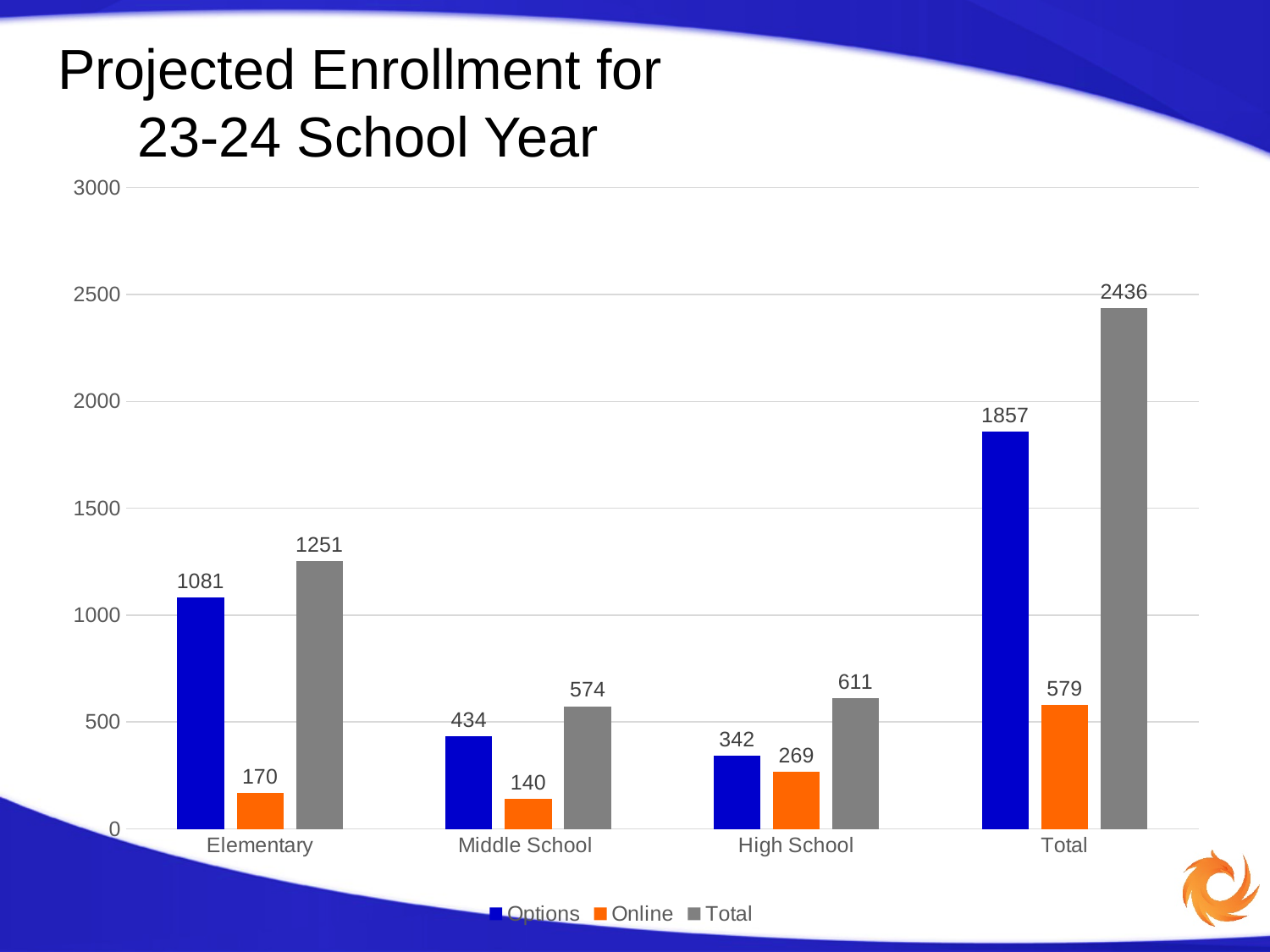
What is the Online value for the Total category? 579 What is the Total value for High School? 611 What is the Options value for Elementary? 1081 Which category has the lowest Online value? Middle School Is the Options value for Middle School greater or less than 500? less What kind of chart is shown on the slide? bar chart What is the Online value for Middle School? 140 Which is larger: the Online value for High School or the Online value for Elementary? High School What is the difference between the Total values for Elementary and Middle School? 677 Among Elementary, Middle School and High School, which has the highest Options value? Elementary How many series does the legend list? 3 How many categories are shown on the x axis? 4